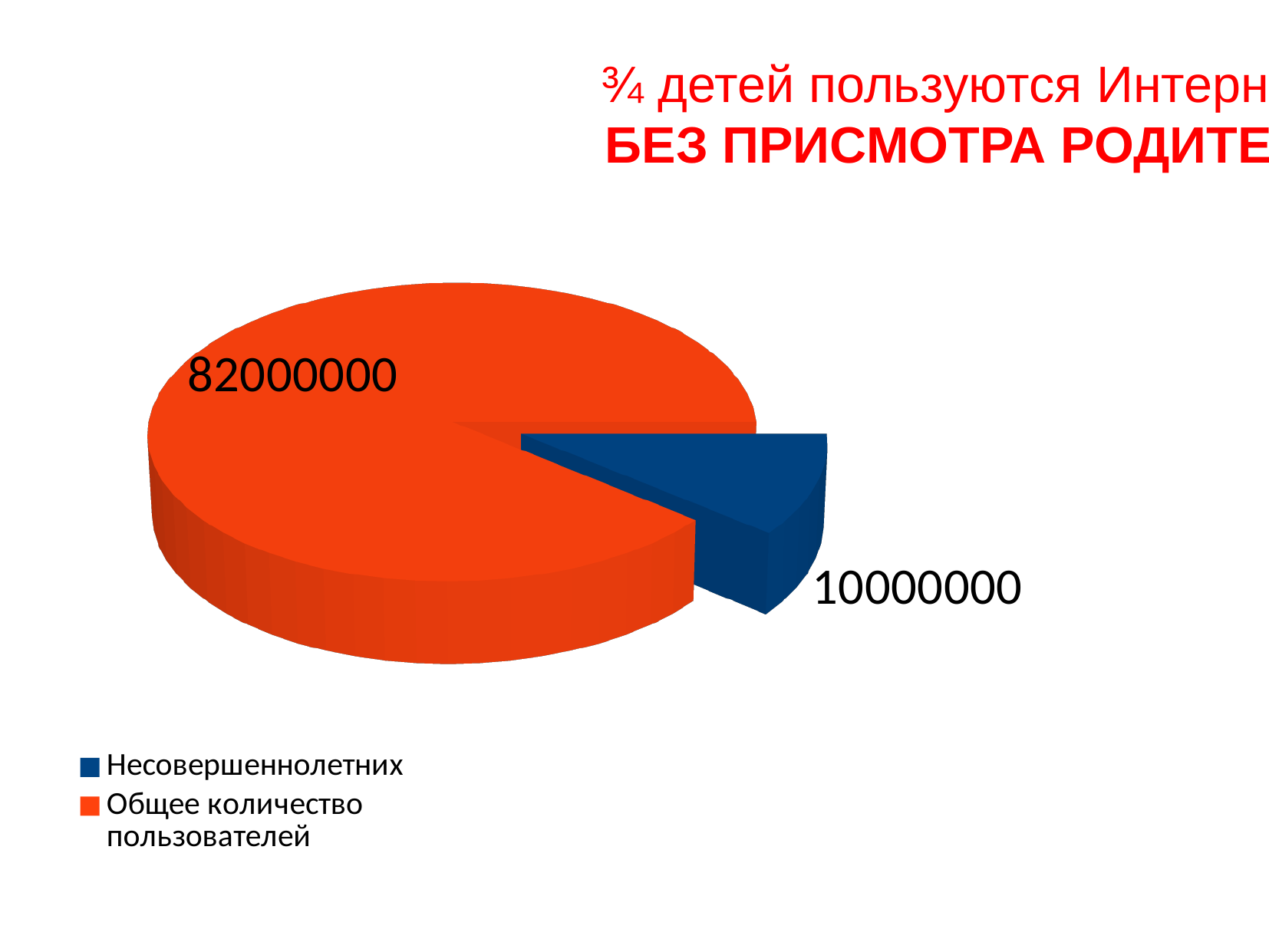
What type of chart is shown on the slide? Pie chart How many entries does the legend of the pie chart list? 2 Which is larger: the value for Несовершеннолетних or the value for Общее количество пользователей? Общее количество пользователей Which slice of the pie chart is the smallest? Несовершеннолетних What is the sum of the two values shown on the pie chart? 92000000 What is the difference between the Общее количество пользователей value and the Несовершеннолетних value? 72000000 What colour is the Общее количество пользователей slice in the pie chart? Orange What value is shown for the Несовершеннолетних slice of the pie chart? 10000000 Which slice of the pie chart is the largest? Общее количество пользователей What value is shown for the Общее количество пользователей slice of the pie chart? 82000000 How many slices does the pie chart have? 2 What colour is the Несовершеннолетних slice in the pie chart? Blue